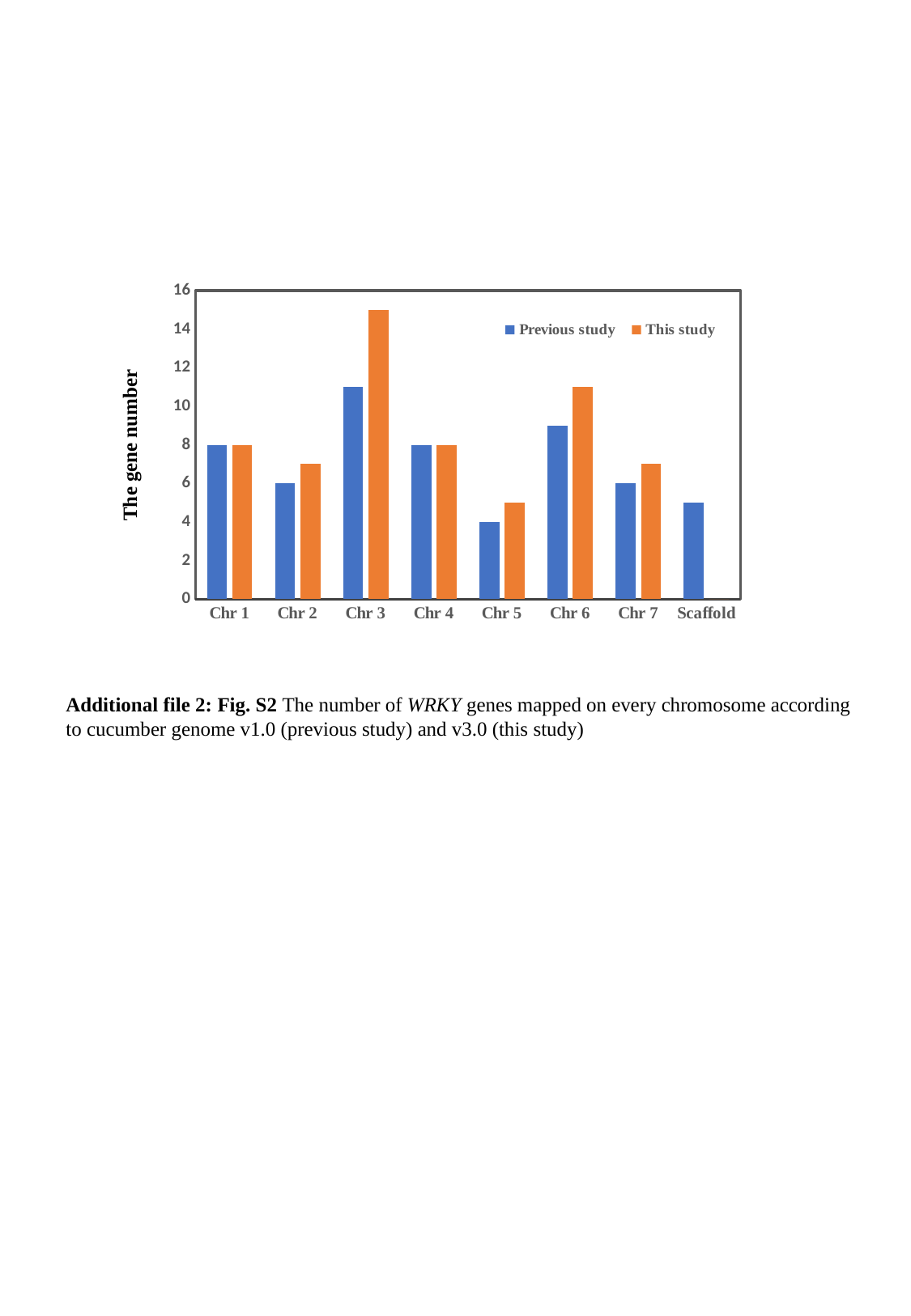
At Chr 3, which series has the larger value, Previous study or This study? This study Which category has the highest value for This study? Chr 3 What kind of chart is shown on the slide? bar chart What is the value for Previous study at Chr 1? 8 What is the difference between the Previous study values for Chr 4 and Chr 5? 4 Which category has the lowest value for Previous study? Chr 5 How many categories are shown on the x axis? 8 Is the value for This study at Chr 3 greater or less than 14? greater How many series does the legend list? 2 What is the value for Previous study at Chr 5? 4 Is the value for This study at Chr 6 greater or less than 10? greater What is the value for This study at Chr 4? 8